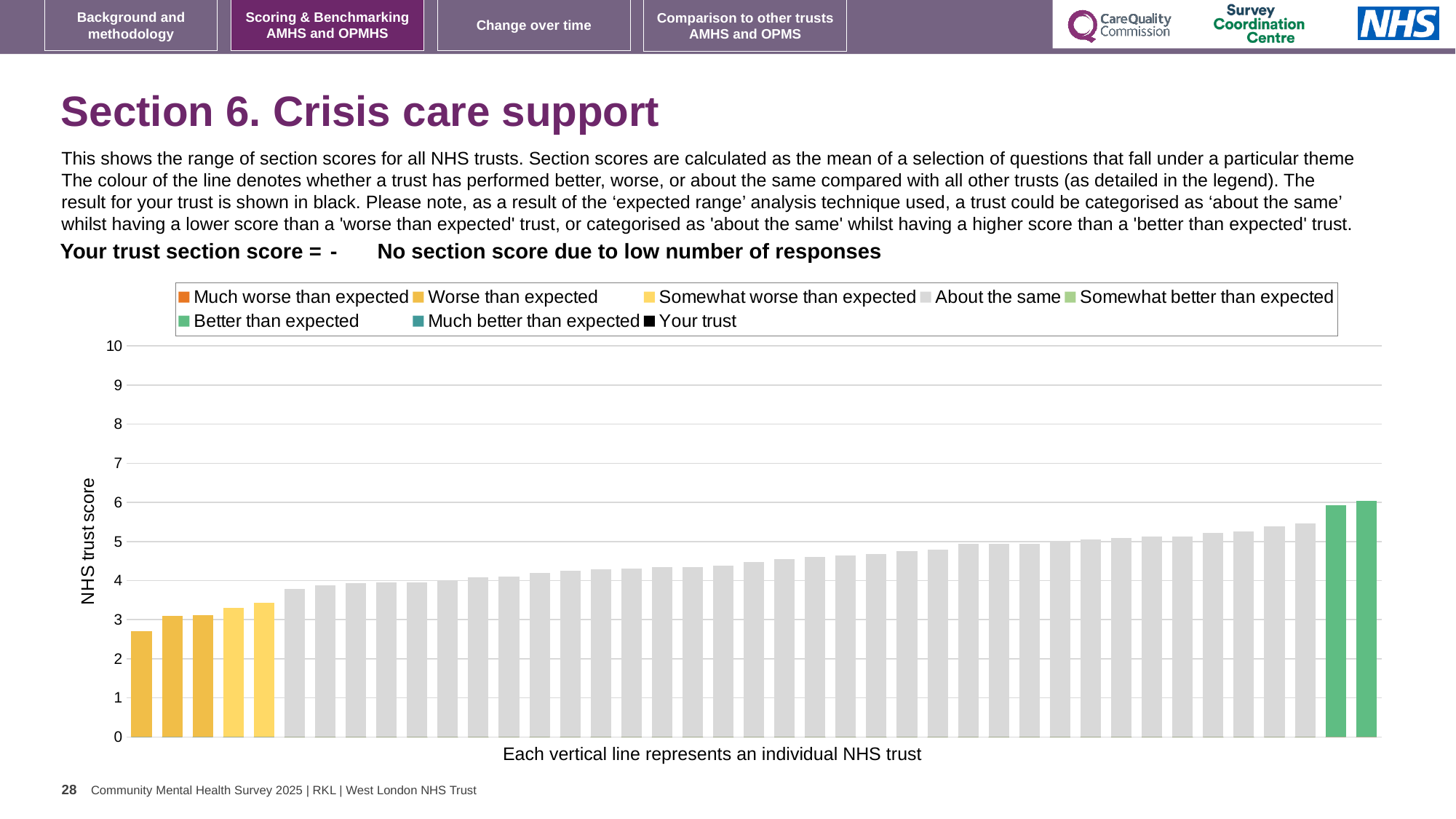
Is any bar in the chart greater than 7? No What is the label on the vertical axis of the chart? NHS trust score What is the trust's section score shown above the chart? - (No section score due to low number of responses) Which legend category does the shortest bar on the left belong to? Worse than expected What kind of chart is shown on the slide? Bar chart Do the bar values rise or fall from left to right along the x axis? rise Which legend category do the two tallest bars on the right belong to? Better than expected Is the value of the highest (rightmost) bar greater or less than 5? greater How many bars are coloured green (Better than expected)? 2 Is the value of the lowest (leftmost) bar greater or less than 3? less How many entries does the chart legend list? 8 What is the maximum value shown on the vertical axis? 10